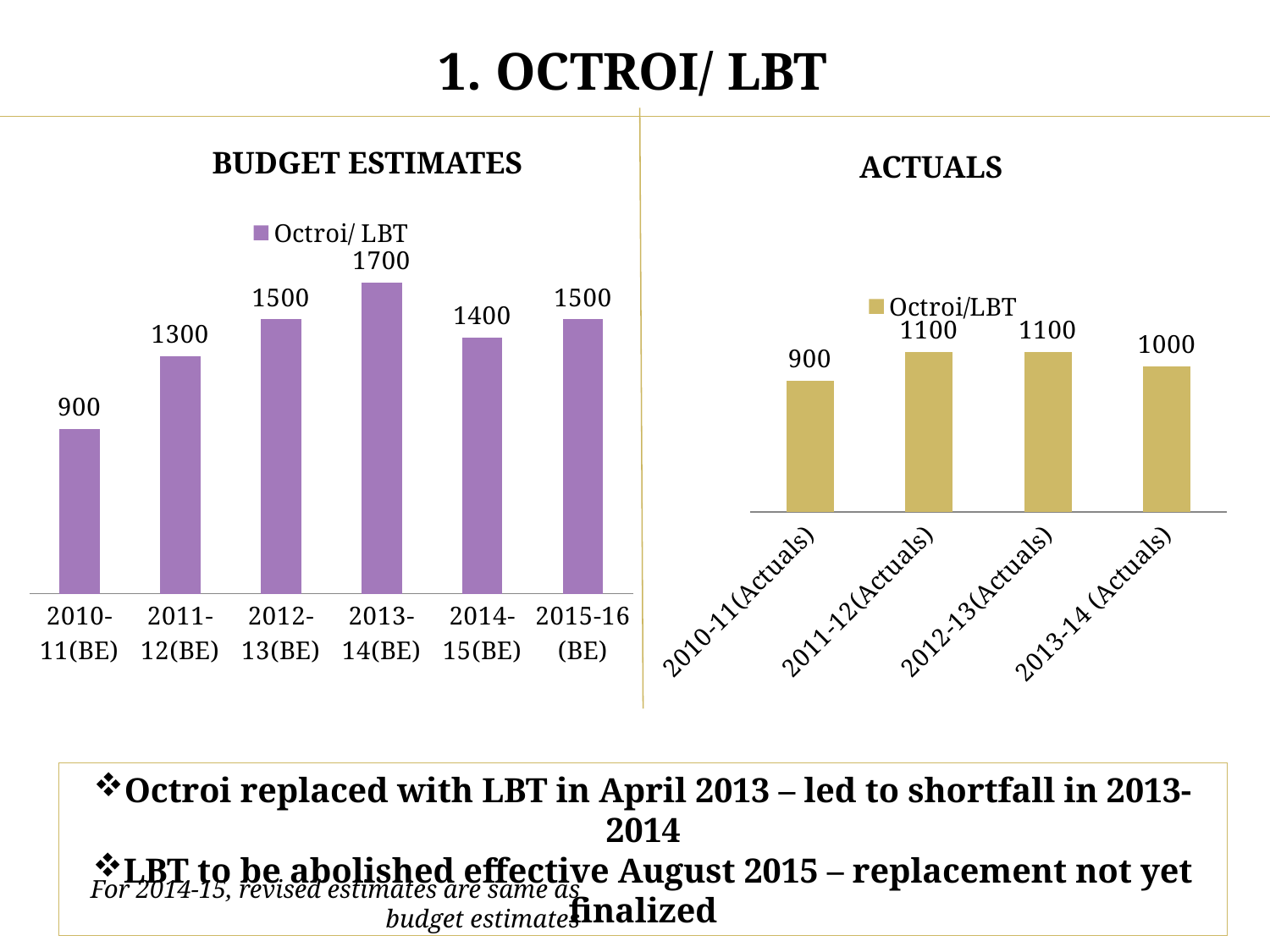
In the BUDGET ESTIMATES chart, how many categories are shown on the x axis? 6 In the ACTUALS chart, what is the value for 2010-11(Actuals)? 900 In the ACTUALS chart, what series name does the legend show? Octroi/LBT In the BUDGET ESTIMATES chart, which category has the lowest value? 2010-11(BE) In the BUDGET ESTIMATES chart, which category has the highest value? 2013-14(BE) In the ACTUALS chart, which category has the lowest value? 2010-11(Actuals) In the BUDGET ESTIMATES chart, what is the difference between the values for 2013-14(BE) and 2014-15(BE)? 300 In the ACTUALS chart, how many categories are shown on the x axis? 4 What kind of chart is the ACTUALS chart? Bar chart In the ACTUALS chart, what is the value for 2013-14 (Actuals)? 1000 In the BUDGET ESTIMATES chart, what is the value for 2013-14(BE)? 1700 In the BUDGET ESTIMATES chart, what is the value for 2010-11(BE)? 900